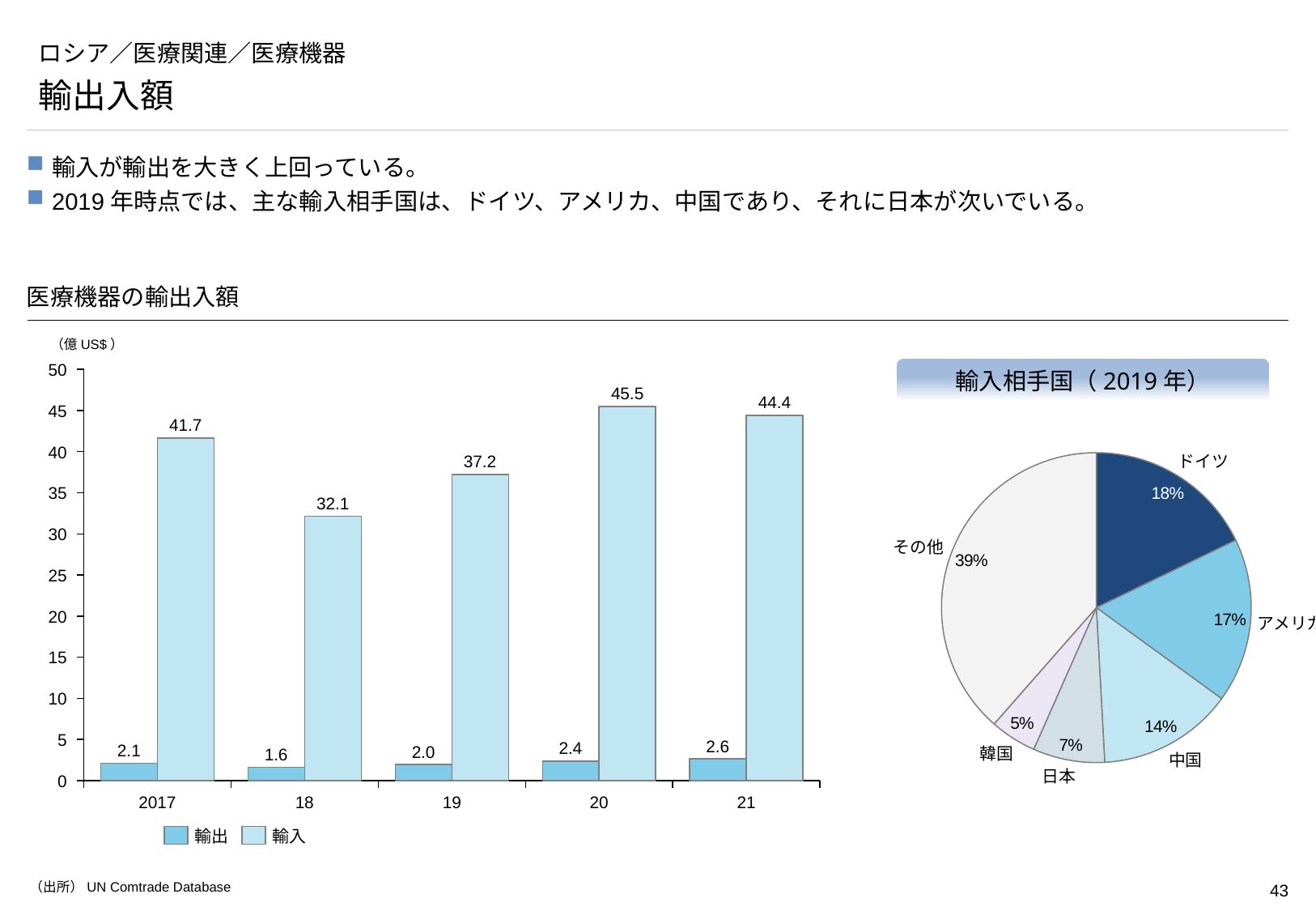
What kind of chart is 輸入相手国（2019年）? pie chart In the bar chart 医療機器の輸出入額, which year has the lowest 輸出 value? 18 In the bar chart 医療機器の輸出入額, what is the value of 輸入 for 2017? 41.7 In the bar chart 医療機器の輸出入額, is the 輸入 value for 18 greater or less than 30? greater In the bar chart 医療機器の輸出入額, what is the difference between 輸入 and 輸出 in 19? 35.2 In the bar chart 医療機器の輸出入額, what is the unit shown on the y axis? 億 US$ In the pie chart 輸入相手国（2019年）, what share does ドイツ have? 18% In the bar chart 医療機器の輸出入額, what is the value of 輸出 for 21? 2.6 In the pie chart 輸入相手国（2019年）, which named country has the smallest share? 韓国 In the bar chart 医療機器の輸出入額, how many years are shown on the x axis? 5 In the bar chart 医療機器の輸出入額, which year has the highest 輸入 value? 20 In the bar chart 医療機器の輸出入額, how many series does the legend list? 2